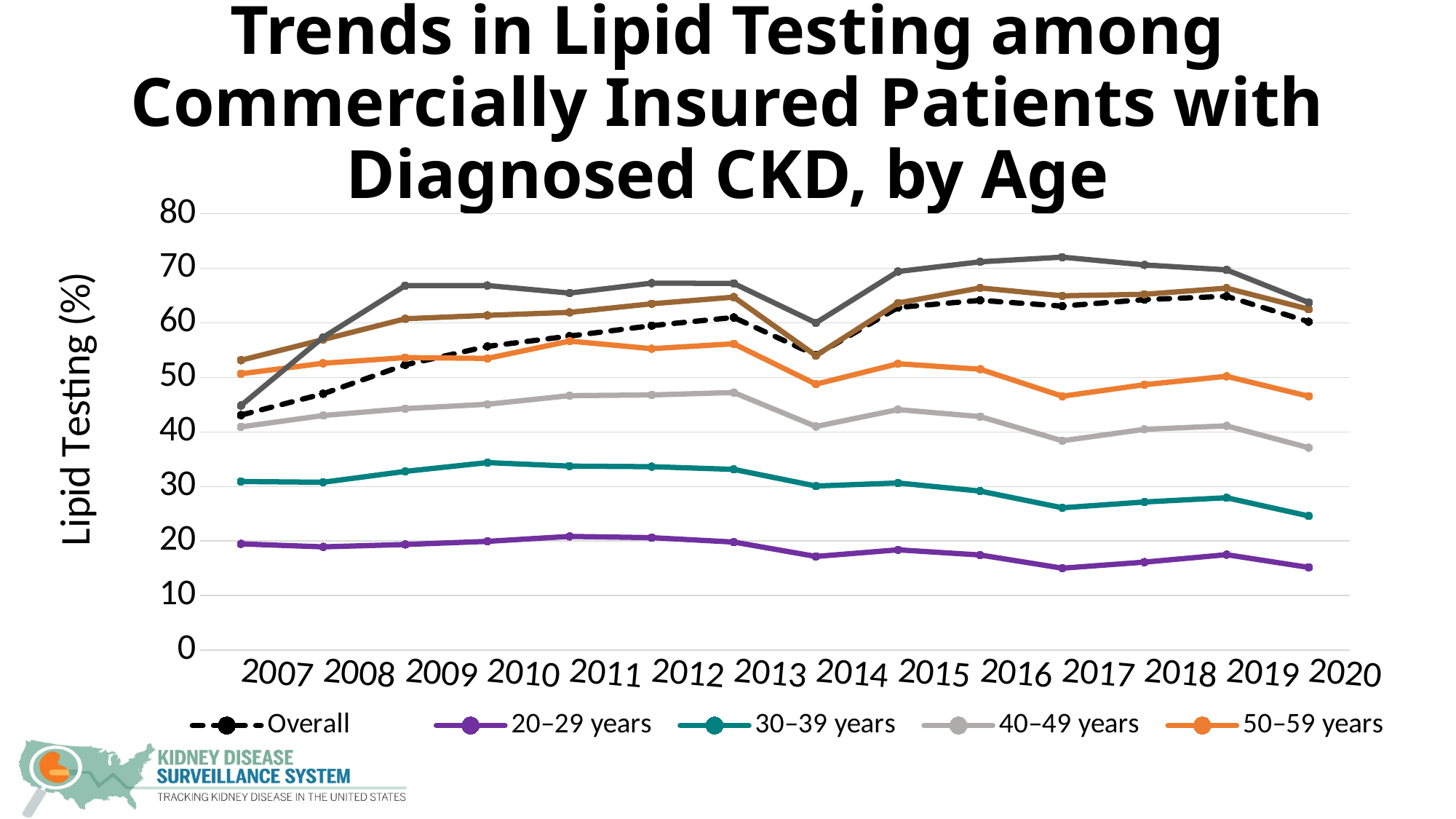
Is the Overall value in 2019 greater or less than 60? greater What kind of chart is shown on the slide? line chart Does the value for 40–49 years rise or fall from 2013 to 2014? fall Is the value for 20–29 years in 2020 greater or less than 20? less Is the value for 50–59 years in 2017 greater or less than 50? less How many series does the legend list? 5 Among the age groups listed in the legend, which has the lowest lipid testing value in 2020? 20–29 years How many years are shown along the x axis? 14 Which series in the legend is drawn with a dashed line? Overall In 2012, which is larger: the value for 30–39 years or the value for 20–29 years? 30–39 years